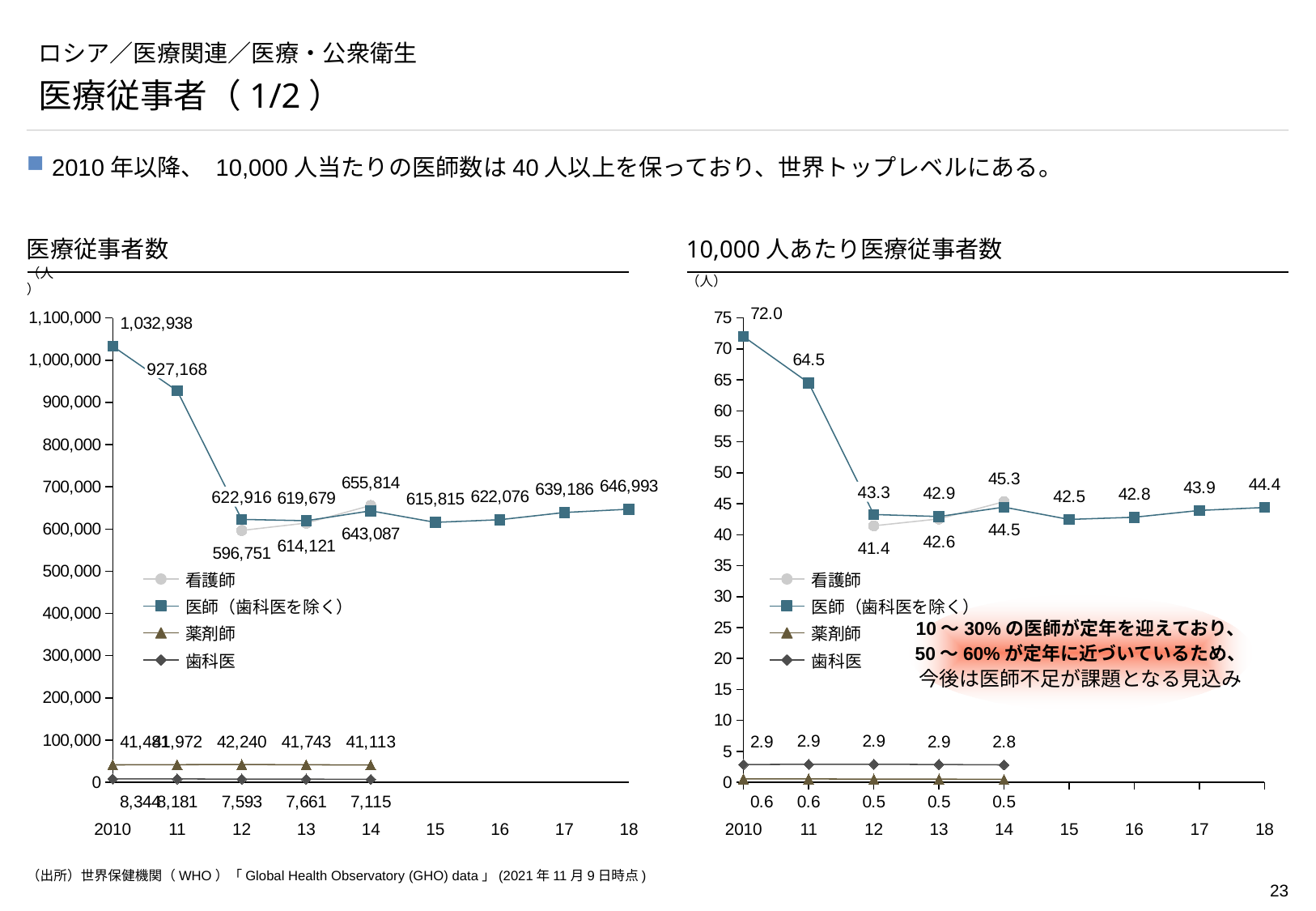
In the left chart (医療従事者数), what is the value for 医師（歯科医を除く） in 2010? 1,032,938 In the right chart (10,000人あたり医療従事者数), what is the value for 看護師 in 2012? 41.4 In the right chart (10,000人あたり医療従事者数), what is the value for 医師（歯科医を除く） in 2018? 44.4 In the right chart (10,000人あたり医療従事者数), which is larger in 2014: 看護師 or 医師（歯科医を除く）? 看護師 In the right chart (10,000人あたり医療従事者数), what is the value for 薬剤師 in 2014? 0.5 In the right chart (10,000人あたり医療従事者数), what is the value for 医師（歯科医を除く） in 2010? 72.0 How many series does the legend of the left chart (医療従事者数) list? 4 What kind of chart is the left chart (医療従事者数)? line chart In the left chart (医療従事者数), what is the value for 看護師 in 2014? 655,814 In the right chart (10,000人あたり医療従事者数), in which year is the 医師（歯科医を除く） value highest? 2010 In the left chart (医療従事者数), what is the difference between the 医師（歯科医を除く） values for 2010 and 2011? 105,770 In the left chart (医療従事者数), what is the value for 医師（歯科医を除く） in 2018? 646,993